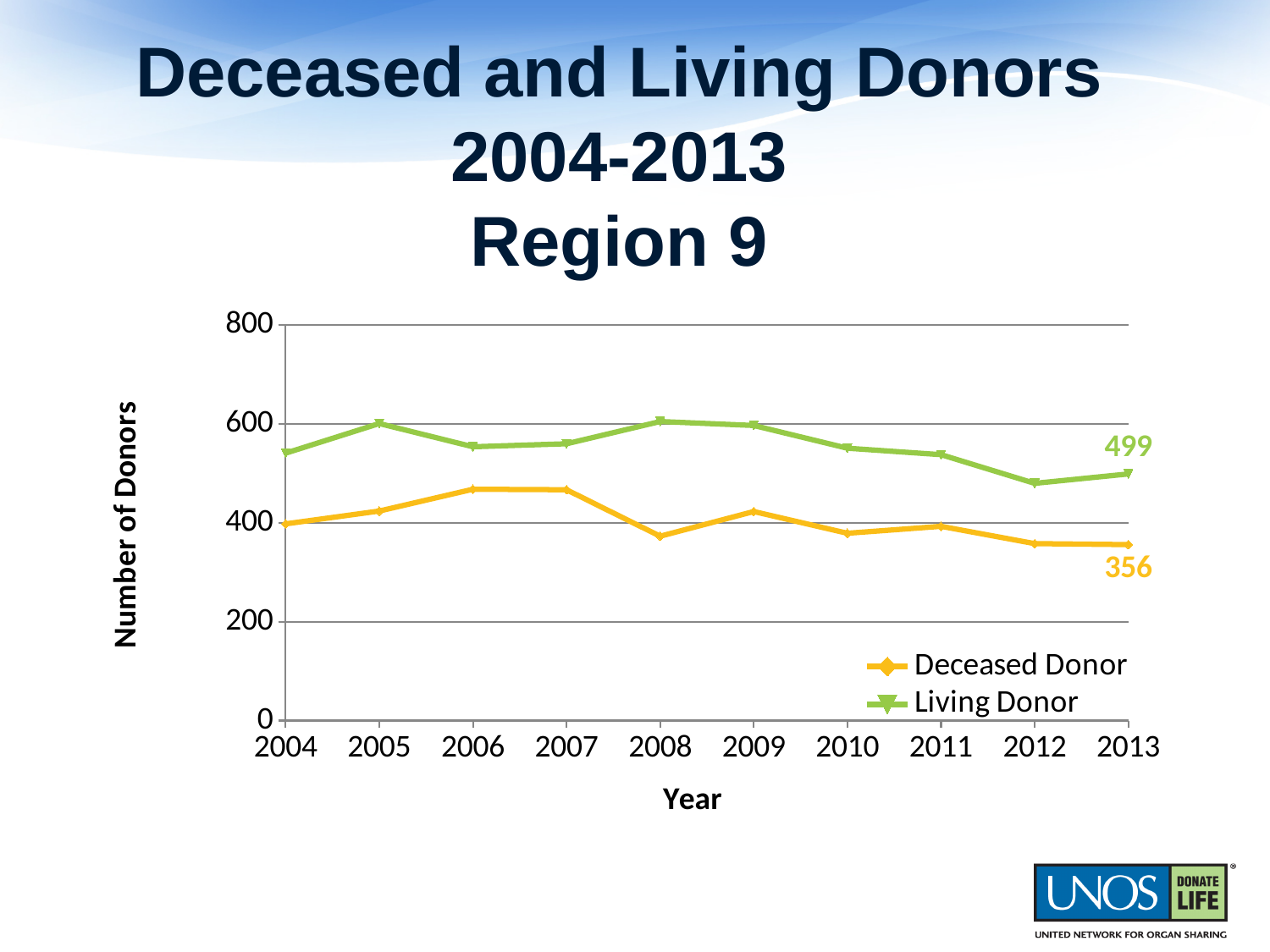
Is the value for Deceased Donor in 2008 greater or less than 400? less Does the Deceased Donor line rise or fall from 2009 to 2013? fall What is the difference between the Living Donor and Deceased Donor values in 2013? 143 What kind of chart is shown on the slide? line chart Is the value for Living Donor in 2012 greater or less than 600? less Is the value for Living Donor in 2005 greater or less than 400? greater How many years are shown on the x axis? 10 In 2013, which series has the larger value, Living Donor or Deceased Donor? Living Donor What is the label on the y axis? Number of Donors What is the value for Living Donor in 2013? 499 What is the value for Deceased Donor in 2013? 356 How many series does the legend list? 2